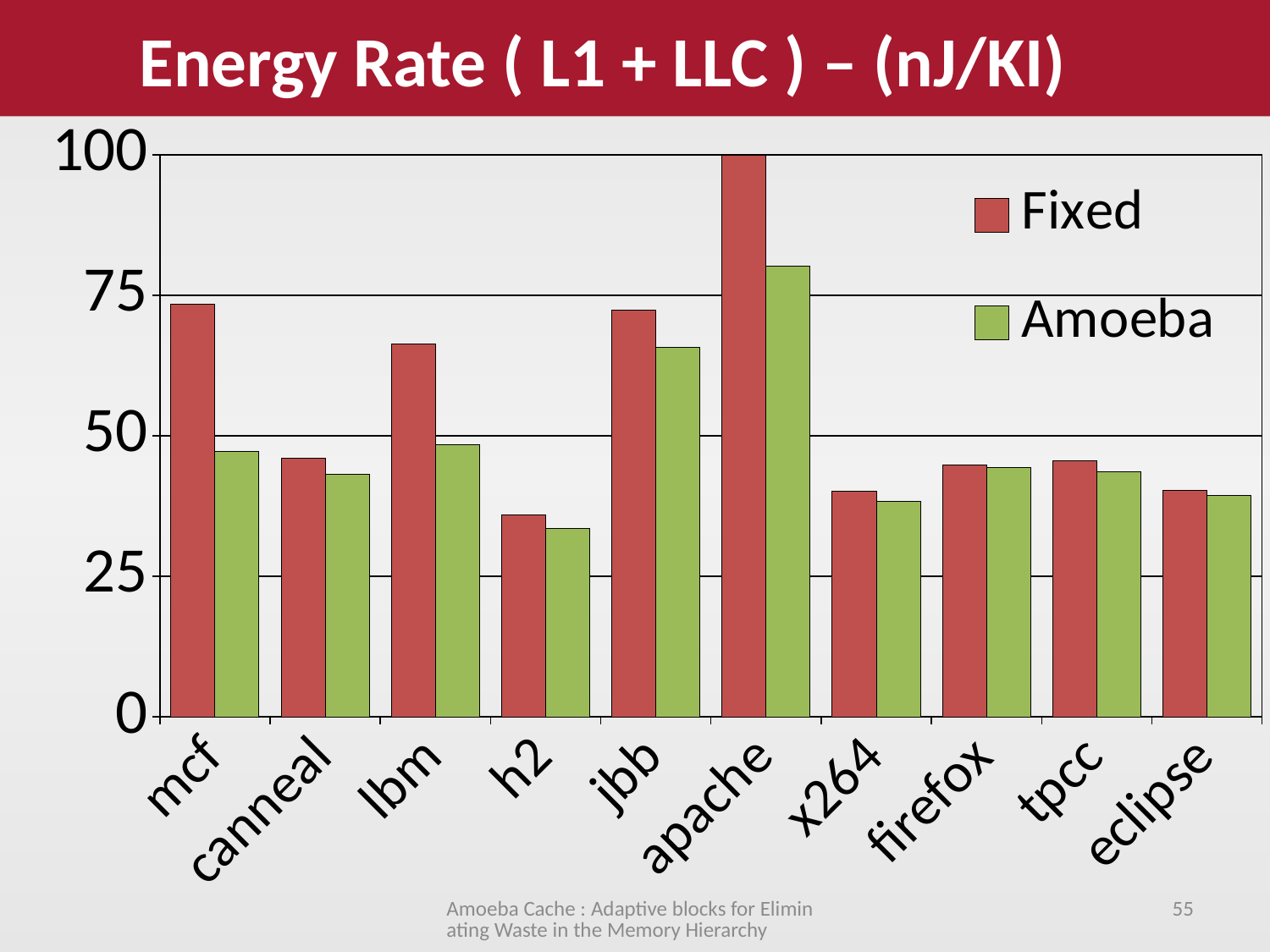
Is the Amoeba value for apache greater or less than 75? greater For mcf, which series has the larger value, Fixed or Amoeba? Fixed Is the Amoeba value for lbm greater or less than 50? less Which benchmark has the lowest Amoeba value? h2 Which benchmark has the highest Fixed value? apache How many series does the legend list? 2 Is the Fixed value for mcf greater or less than 50? greater What kind of chart is shown on the slide? bar chart How many benchmark categories are shown along the x axis? 10 Which benchmark has the lowest Fixed value? h2 Which colour represents the Amoeba series in the legend? green Which benchmark has the highest Amoeba value? apache